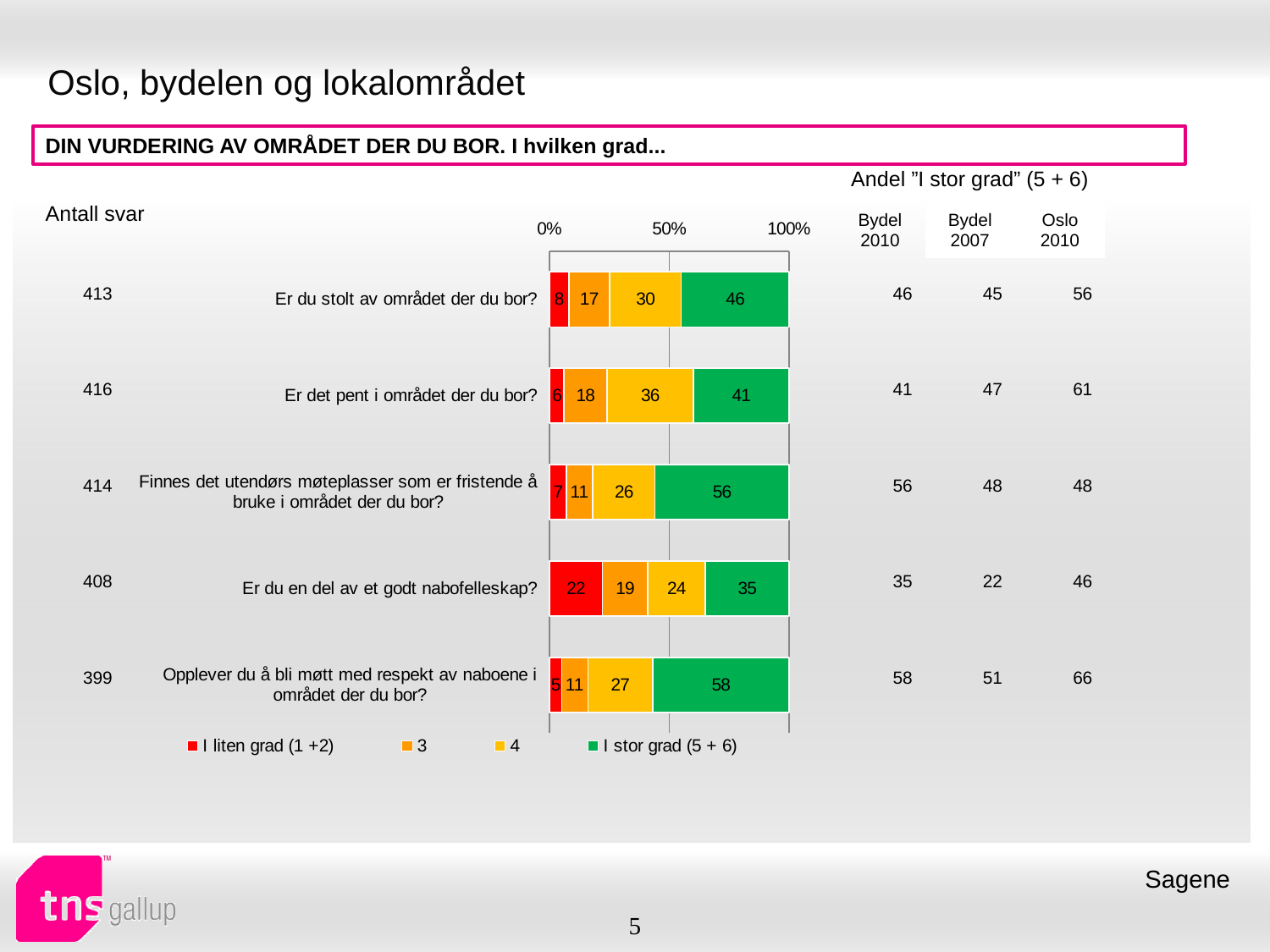
What is the total of the stacked bar for "Finnes det utendørs møteplasser som er fristende å bruke i området der du bor?"? 100 What is the value of "I liten grad (1 +2)" for "Er du en del av et godt nabofelleskap?"? 22 What is the value of series "4" for "Er det pent i området der du bor?"? 36 Which is larger: the "3" value for "Er du stolt av området der du bor?" or for "Er du en del av et godt nabofelleskap?"? Er du en del av et godt nabofelleskap? Which question has the lowest "I liten grad (1 +2)" value? Opplever du å bli møtt med respekt av naboene i området der du bor? How many questions (categories) are shown in the chart? 5 What is the difference between the "I stor grad (5 + 6)" values for "Er du stolt av området der du bor?" and "Er det pent i området der du bor?"? 5 What kind of chart is shown on the slide? Stacked bar chart Which question has the highest "I stor grad (5 + 6)" value? Opplever du å bli møtt med respekt av naboene i området der du bor? What is the value of "I stor grad (5 + 6)" for "Er du stolt av området der du bor?"? 46 How many series does the legend list? 4 What colour represents "I stor grad (5 + 6)" in the chart? Green